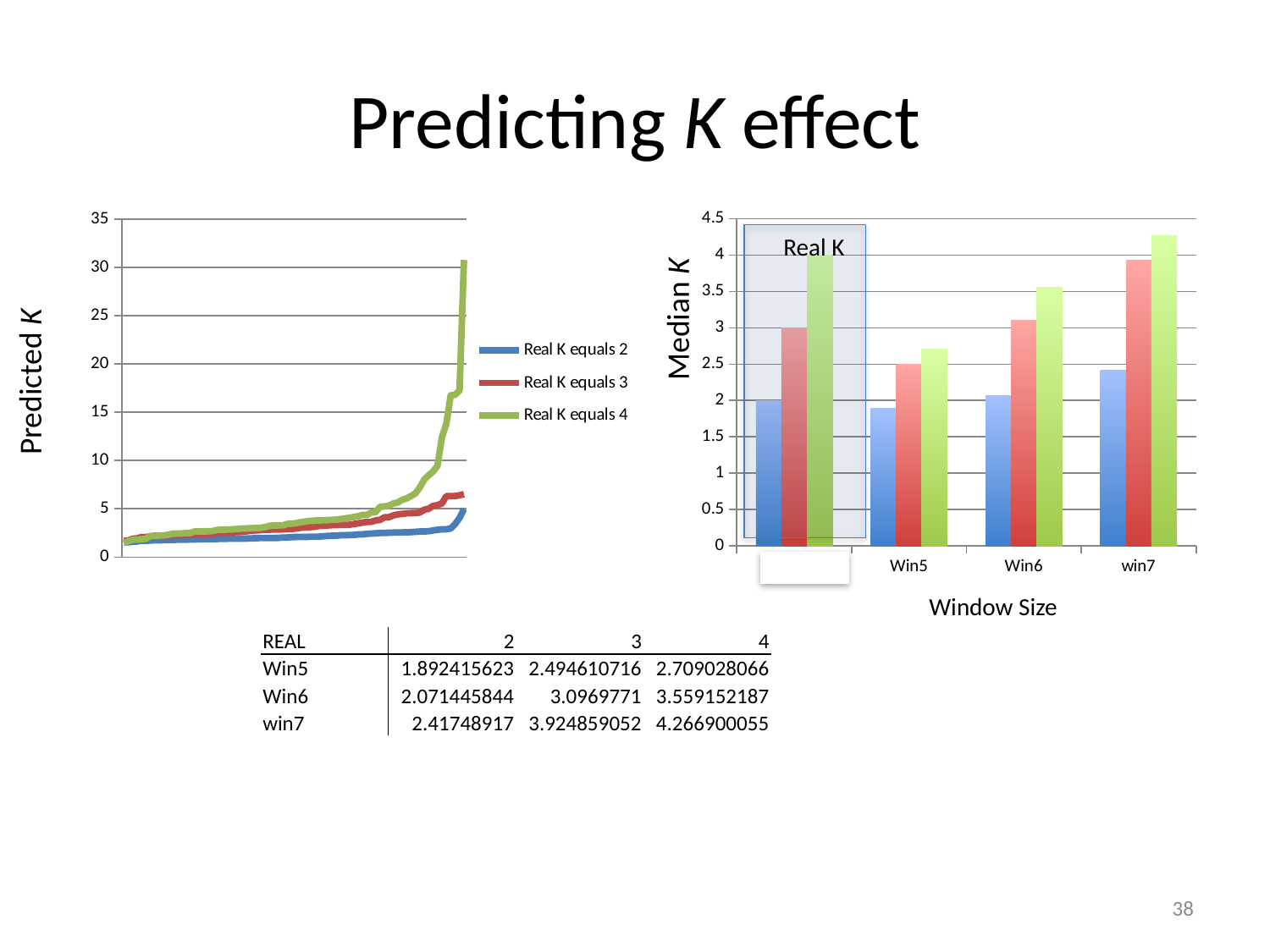
What kind of chart is the left chart (Predicted K)? line chart How many series does the legend of the left chart list? 3 In the left chart, which series reaches the highest value? Real K equals 4 In the right chart, what is the value of the green bar in the 'Real K' group? 4 In the right chart, what is the value of the blue bar in the 'Real K' group? 2 In the right chart, is the green bar for win7 greater or less than 4? greater In the left chart, is the highest value of the 'Real K equals 4' series greater or less than 25? greater In the left chart, do the values of the 'Real K equals 4' series rise or fall along the x axis? rise What kind of chart is the right chart (Median K vs Window Size)? bar chart In the right chart, is the red bar for Win6 larger or smaller than the red bar for Win5? larger In the right chart, which window size has the tallest green bar? win7 In the left chart, is the highest value of the 'Real K equals 2' series greater or less than 10? less